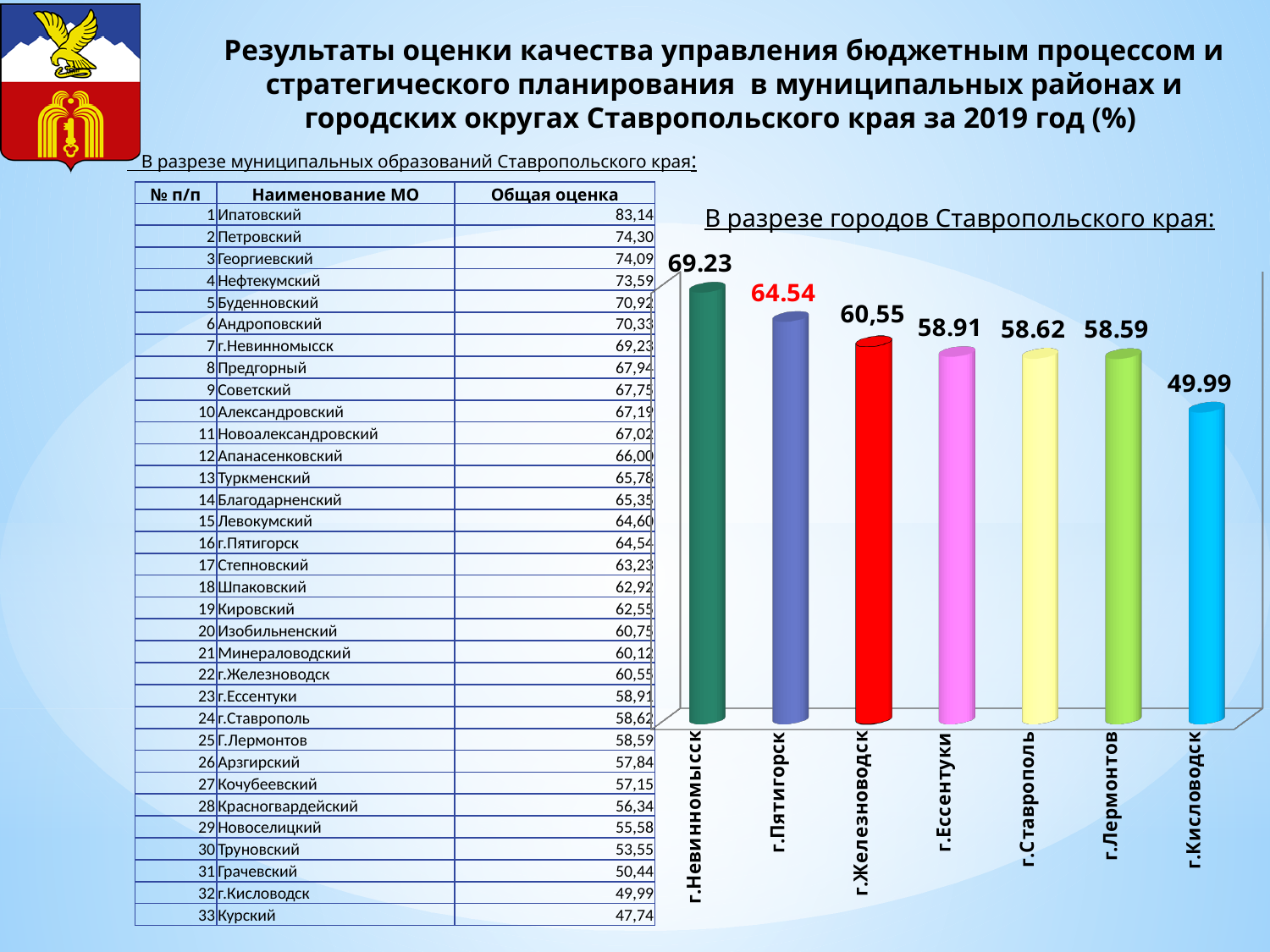
What is the value shown for г.Кисловодск? 49.99 Do the values rise or fall from left to right across the chart? fall What is the value shown for г.Железноводск? 60,55 What is the difference between the values for г.Невинномысск and г.Кисловодск? 19.24 What is the value shown for г.Невинномысск? 69.23 Which has a larger value, г.Пятигорск or г.Ессентуки? г.Пятигорск What is the value shown for г.Пятигорск? 64.54 What is the heading written above the chart? В разрезе городов Ставропольского края: How many cities are plotted in the chart? 7 Which city has the highest value in the chart? г.Невинномысск What type of chart is shown on the slide? bar chart Which city has the lowest value in the chart? г.Кисловодск